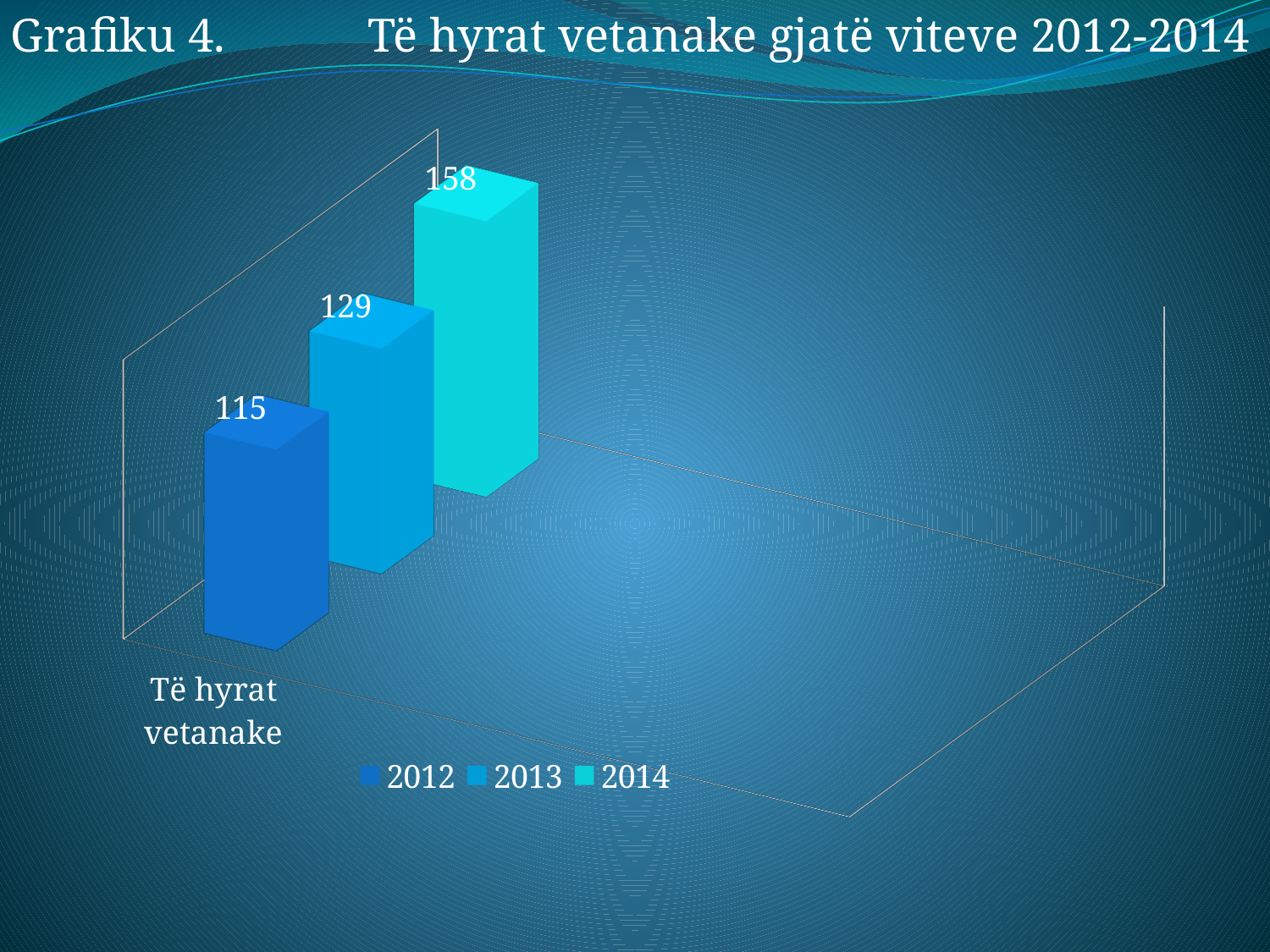
What is the value for 2014 in the chart? 158 What is the difference between the values for 2013 and 2012? 14 What is the value for 2013 in the chart? 129 Do the values rise or fall from 2012 to 2014? Rise Which year has the highest value? 2014 What is the category label shown on the x axis? Të hyrat vetanake Which year has the lowest value? 2012 Which is larger, the value for 2013 or the value for 2014? 2014 What is the difference between the values for 2014 and 2012? 43 How many series does the legend list? 3 What is the value for 2012 in the chart? 115 What kind of chart is shown on the slide? Bar chart